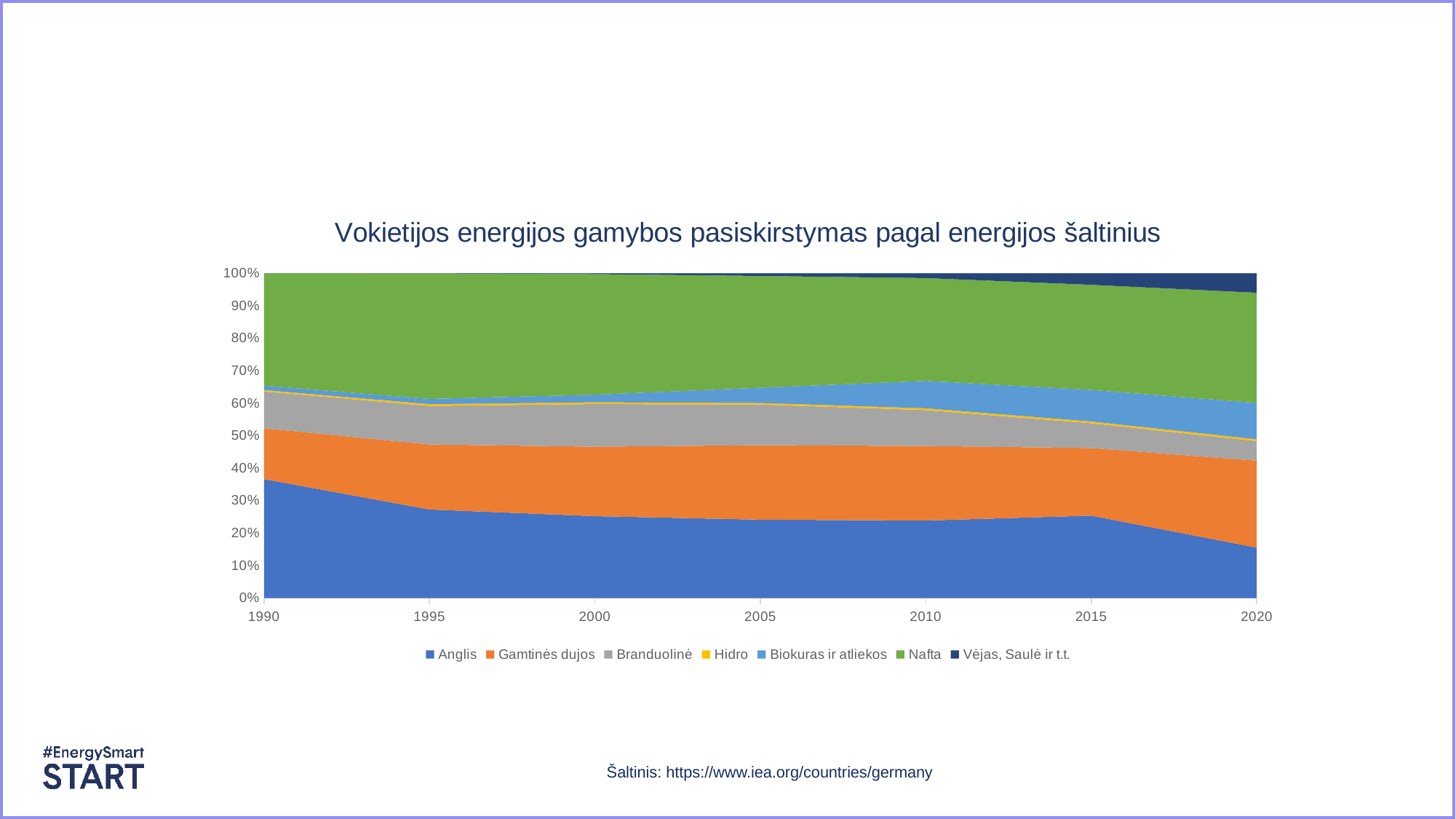
Which series is shown in green in the chart? Nafta How many years are marked on the x axis? 7 Is the share of Anglis in 2020 greater or less than 20%? less Does the share of Vėjas, Saulė ir t.t. rise or fall from 1990 to 2020? rise What kind of chart is shown on the slide? Stacked area chart What is the title of the chart? Vokietijos energijos gamybos pasiskirstymas pagal energijos šaltinius Which is larger, the share of Anglis in 1990 or in 2020? 1990 Which is larger in 2020, the share of Nafta or the share of Gamtinės dujos? Nafta Does the share of Anglis rise or fall from 1990 to 2020? fall Is the share of Anglis in 1990 greater or less than 30%? greater Is the share of Anglis in 2015 greater or less than 20%? greater How many series does the legend list? 7